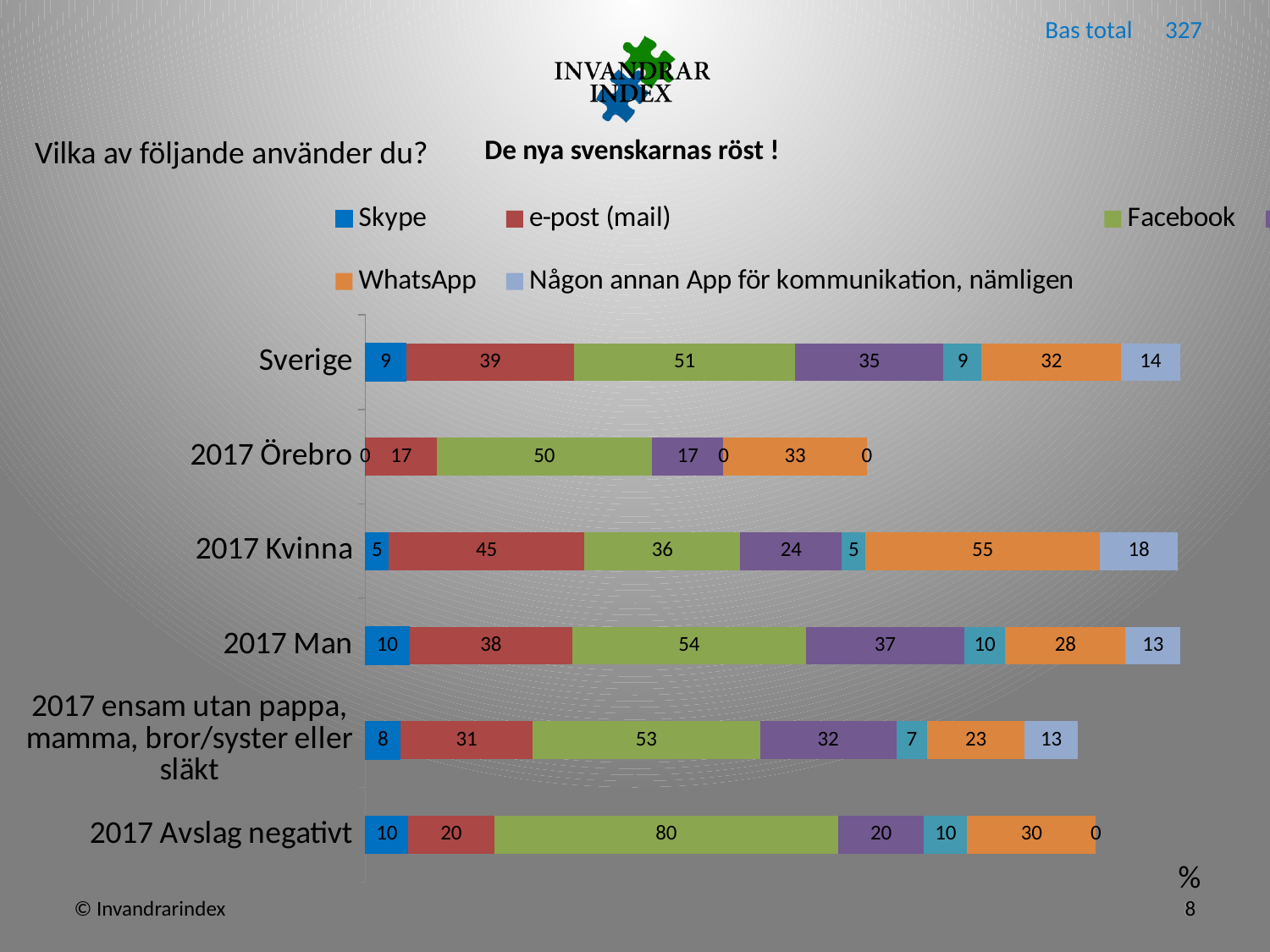
What is the difference between the Facebook values for Sverige and 2017 Kvinna? 15 How many categories (bars) are shown on the chart? 6 What is the total of all segments in the Sverige bar? 189 What is the Facebook value for Sverige? 51 What is the 'Bas total' shown on the slide? 327 What is the e-post (mail) value for 2017 Man? 38 What is the Skype value for 2017 Örebro? 0 Which category has the highest Facebook value? 2017 Avslag negativt What kind of chart is shown on the slide? Stacked bar chart Which category has the lowest WhatsApp value? 2017 ensam utan pappa, mamma, bror/syster eller släkt Which has the larger e-post (mail) value, 2017 Kvinna or 2017 Man? 2017 Kvinna What is the WhatsApp value for 2017 Kvinna? 55